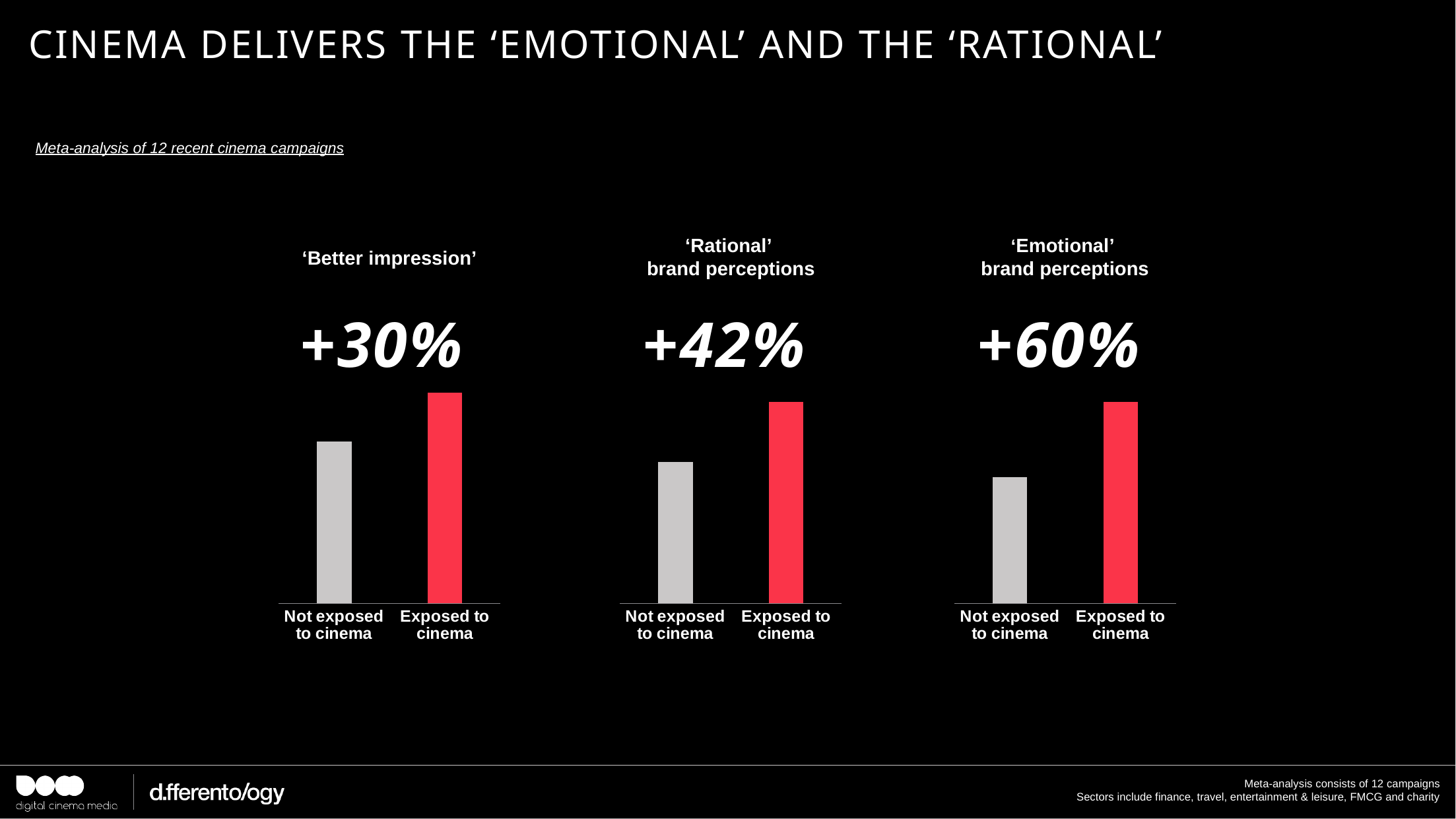
What kind of chart is used under the 'Better impression' heading? bar chart In the 'Better impression' chart, which bar is taller, 'Not exposed to cinema' or 'Exposed to cinema'? Exposed to cinema What uplift percentage is printed above the 'Emotional' brand perceptions chart? +60% What uplift percentage is printed above the 'Better impression' chart? +30% In the 'Emotional' brand perceptions chart, which category has the highest bar? Exposed to cinema In the 'Emotional' brand perceptions chart, what colour is the 'Exposed to cinema' bar? red Which of the three charts shows the largest printed uplift percentage? 'Emotional' brand perceptions Which of the three charts shows the smallest printed uplift percentage? 'Better impression' In the 'Rational' brand perceptions chart, which category has the lowest bar? Not exposed to cinema How many bars are shown in the 'Rational' brand perceptions chart? 2 What uplift percentage is printed above the 'Rational' brand perceptions chart? +42% How many separate bar charts are shown on the slide? 3